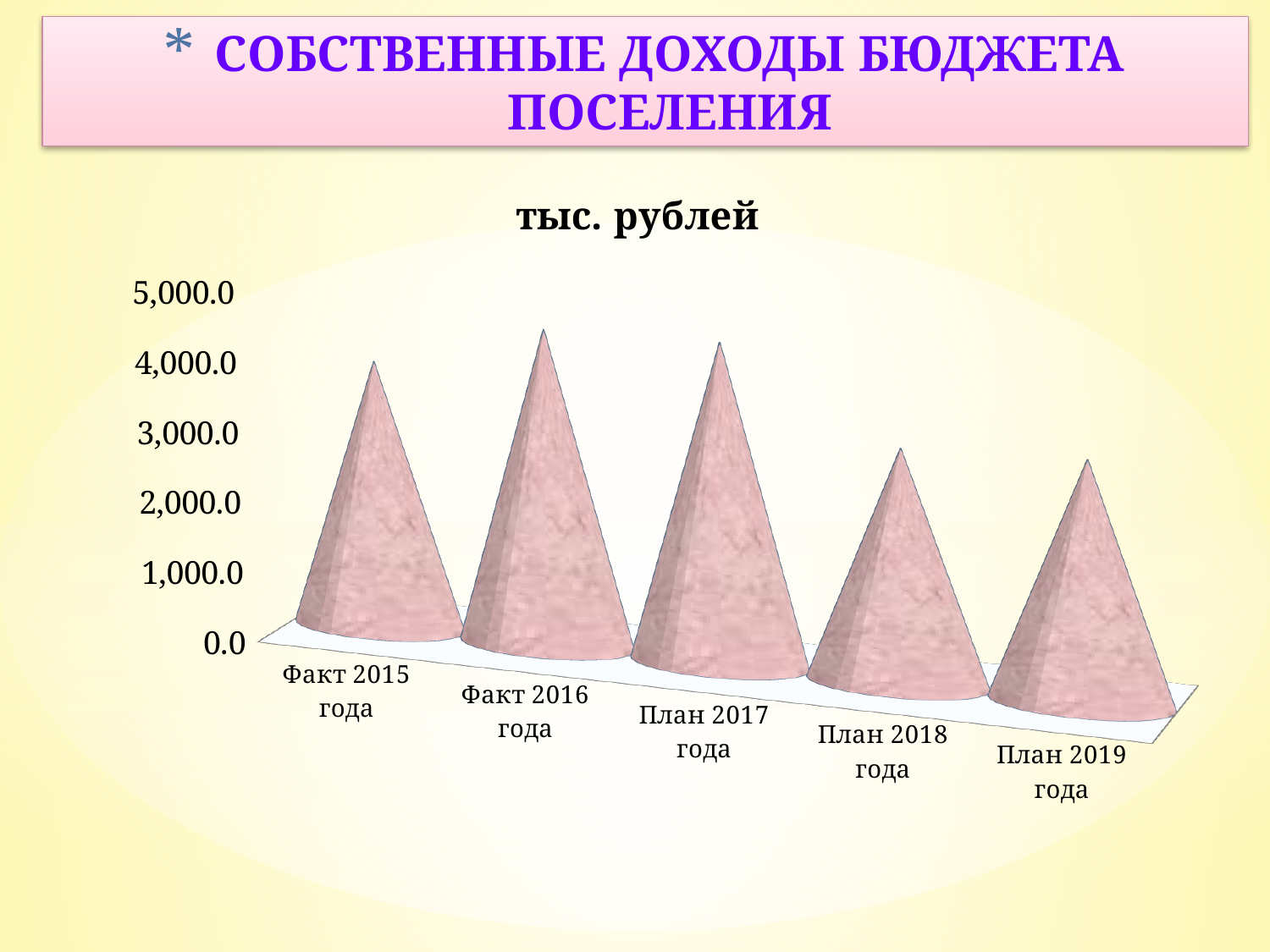
What is the title of the chart? тыс. рублей Is the value for План 2018 года greater or less than 4,000.0? less Is the value for Факт 2016 года greater or less than 4,000.0? greater Do the values rise or fall from План 2017 года to План 2019 года? fall Is the value for Факт 2015 года greater or less than 3,000.0? greater Do the values rise or fall from Факт 2015 года to Факт 2016 года? rise What kind of chart is shown on the slide? bar chart Which is larger, the value for Факт 2015 года or the value for План 2018 года? Факт 2015 года Which is larger, the value for Факт 2016 года or the value for План 2019 года? Факт 2016 года How many categories are shown on the x axis of the chart? 5